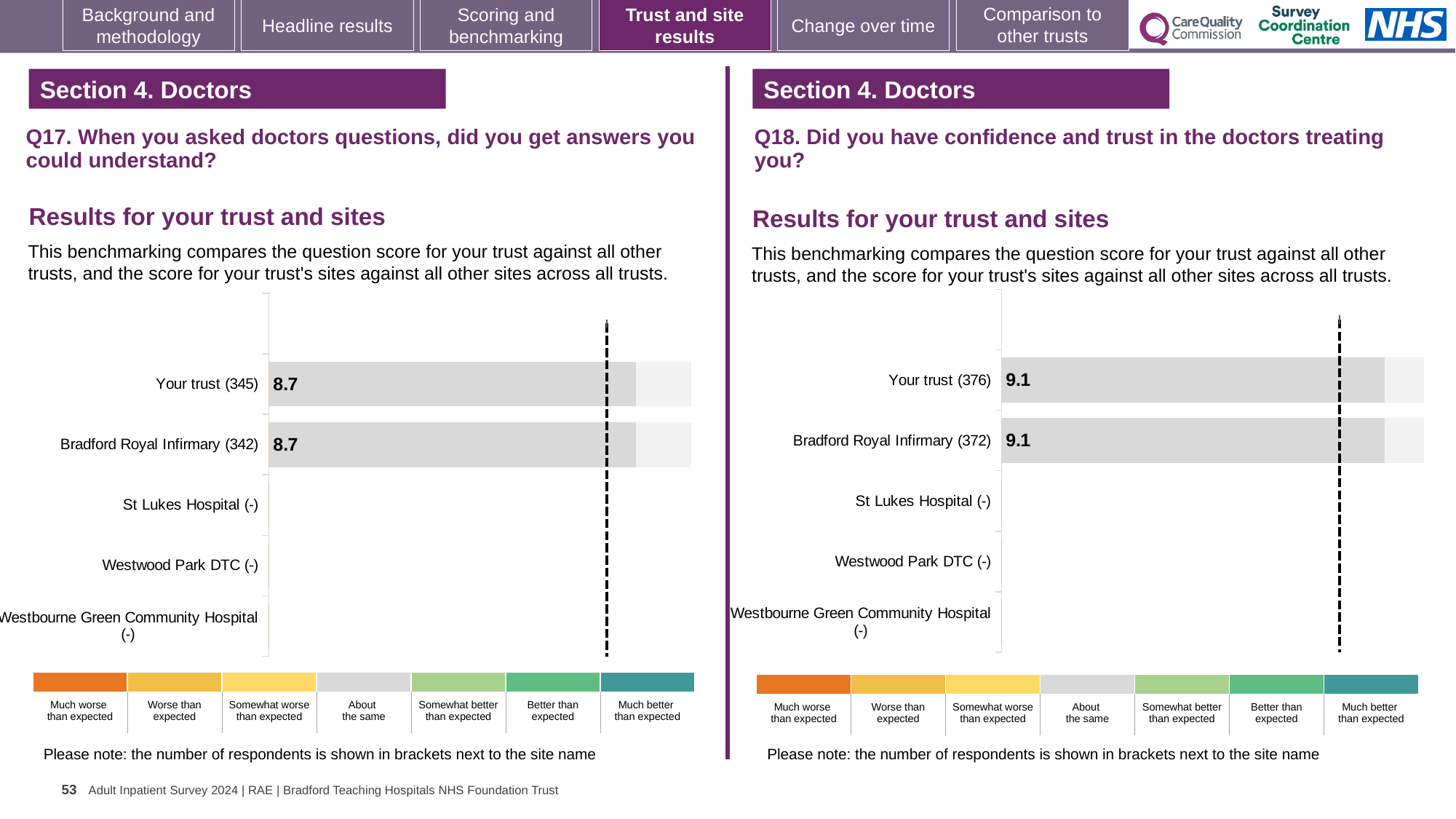
In the Q17 chart on the left, how many site or trust categories are listed on the vertical axis? 5 What kind of chart is the Q17 chart on the left? Bar chart In the Q17 chart on the left, what is the score for Your trust? 8.7 In the Q18 chart on the right, how many categories have a plotted bar with a score? 2 In the Q18 chart on the right, how many respondents are shown in brackets for Your trust? 376 In the Q17 chart on the left, what is the score for Bradford Royal Infirmary? 8.7 In the Q18 chart on the right, what is the score for Bradford Royal Infirmary? 9.1 In the colour key below the Q17 chart, which category is shown in grey? About the same In the Q17 chart on the left, how many respondents are shown in brackets for Bradford Royal Infirmary? 342 In the Q18 chart on the right, which category label is shown for the bottom row of the chart? Westbourne Green Community Hospital (-) In the Q18 chart on the right, what is the score for Your trust? 9.1 In the Q17 chart on the left, what is the difference between the scores for Your trust and Bradford Royal Infirmary? 0.0